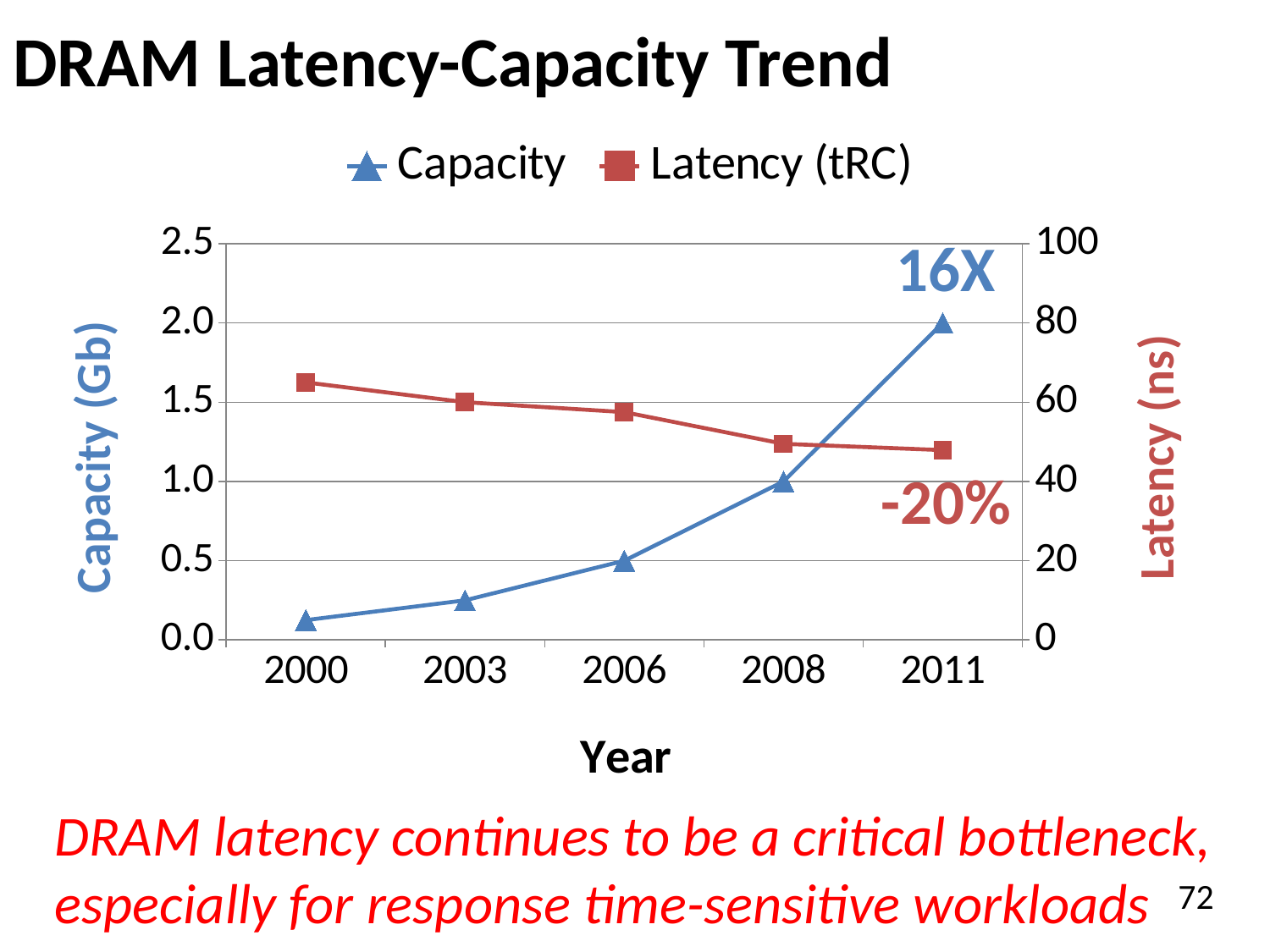
What is the Capacity value for 2008? 1.0 In which year is Latency (tRC) highest? 2000 In which year is Capacity highest? 2011 How many series does the legend list? 2 What is the Capacity value for 2011? 2.0 What annotation is printed next to the Capacity line near 2011? 16X Does the Latency (tRC) series rise or fall from 2000 to 2011? fall Does the Capacity series rise or fall from 2000 to 2011? rise How many years are plotted along the x axis? 5 Is the Latency (tRC) value for 2011 greater or less than 60? less Which is larger, the Latency (tRC) value for 2000 or for 2008? 2000 What kind of chart is shown on the slide? line chart